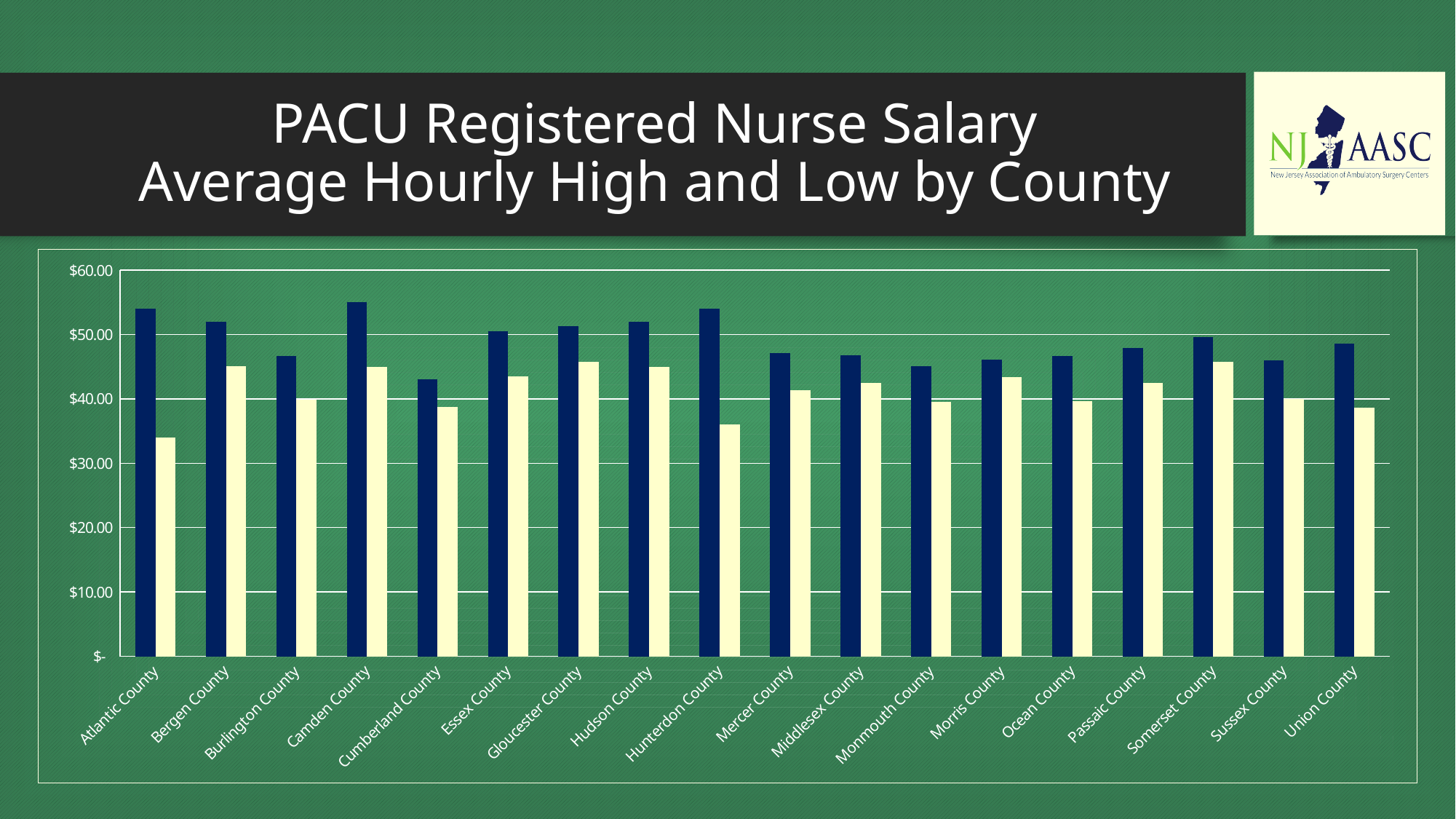
Which county has the lowest light yellow bar? Atlantic County Is the value of the dark blue bar for Cumberland County greater or less than $50.00? less What kind of chart is shown on the slide? bar chart What is the title of the chart on the slide? PACU Registered Nurse Salary Average Hourly High and Low by County Is the value of the light yellow bar for Hunterdon County greater or less than $40.00? less Is the value of the light yellow bar for Bergen County greater or less than $40.00? greater Which is larger, the dark blue bar for Atlantic County or the dark blue bar for Cumberland County? Atlantic County How many bars are plotted for each county? 2 How many counties are shown on the x axis of the chart? 18